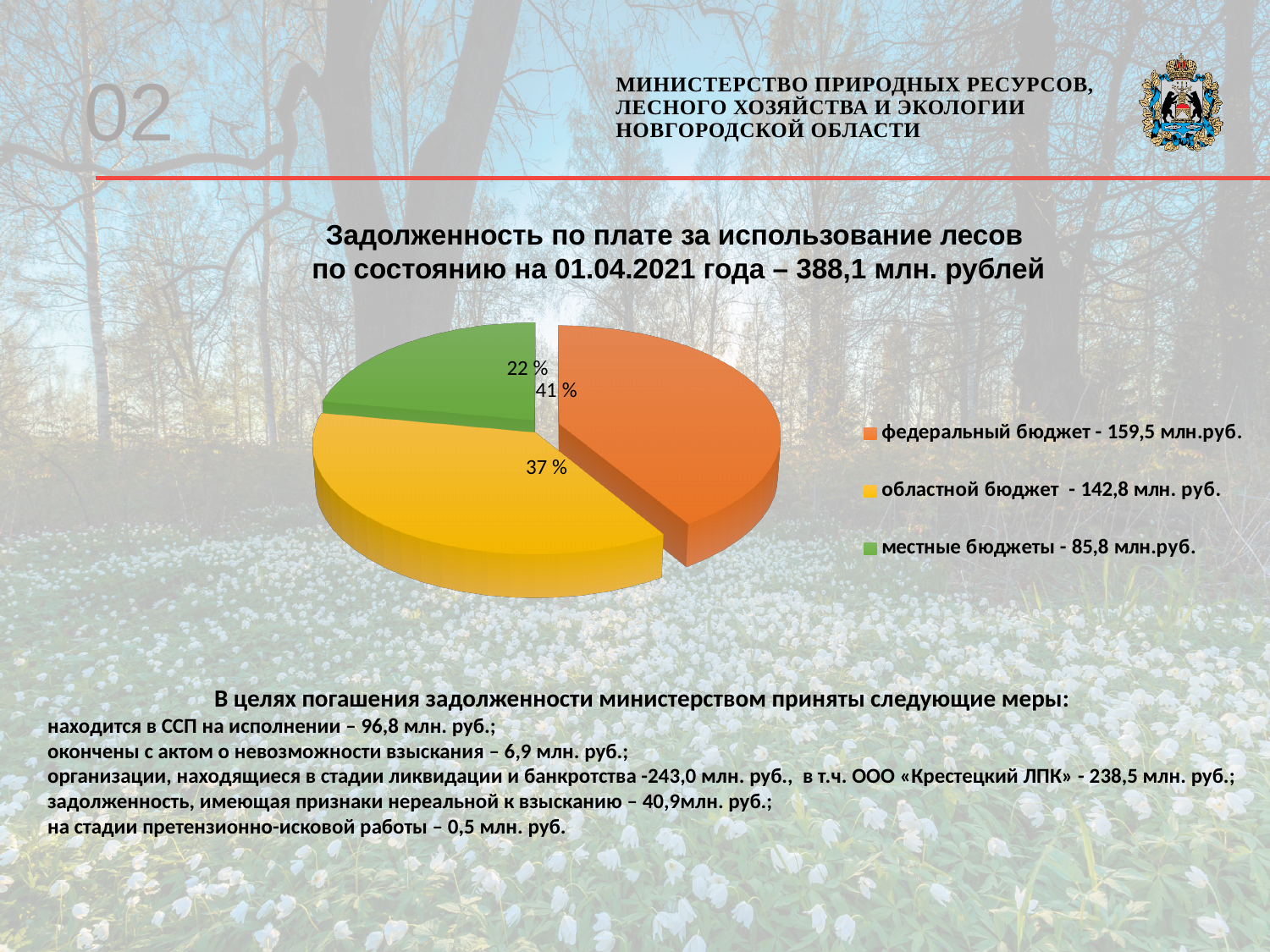
How many entries does the legend of the pie chart list? 3 What share of the pie does the regional budget (областной бюджет) slice represent? 37 % What share of the pie does the local budgets (местные бюджеты) slice represent? 22 % According to the legend, what is the debt amount for the local budgets (местные бюджеты)? 85,8 млн.руб. Which category has the largest slice of the pie? федеральный бюджет What is the difference in million rubles between the federal budget debt (159,5) and the regional budget debt (142,8)? 16,7 млн. руб. Which category has the smallest slice of the pie? местные бюджеты How many slices does the pie chart have? 3 Which is larger: the debt for the regional budget (областной бюджет) or for the local budgets (местные бюджеты)? областной бюджет What type of chart is shown on the slide? Pie chart According to the legend, what is the debt amount for the federal budget (федеральный бюджет)? 159,5 млн.руб. What share of the pie does the federal budget (федеральный бюджет) slice represent? 41 %